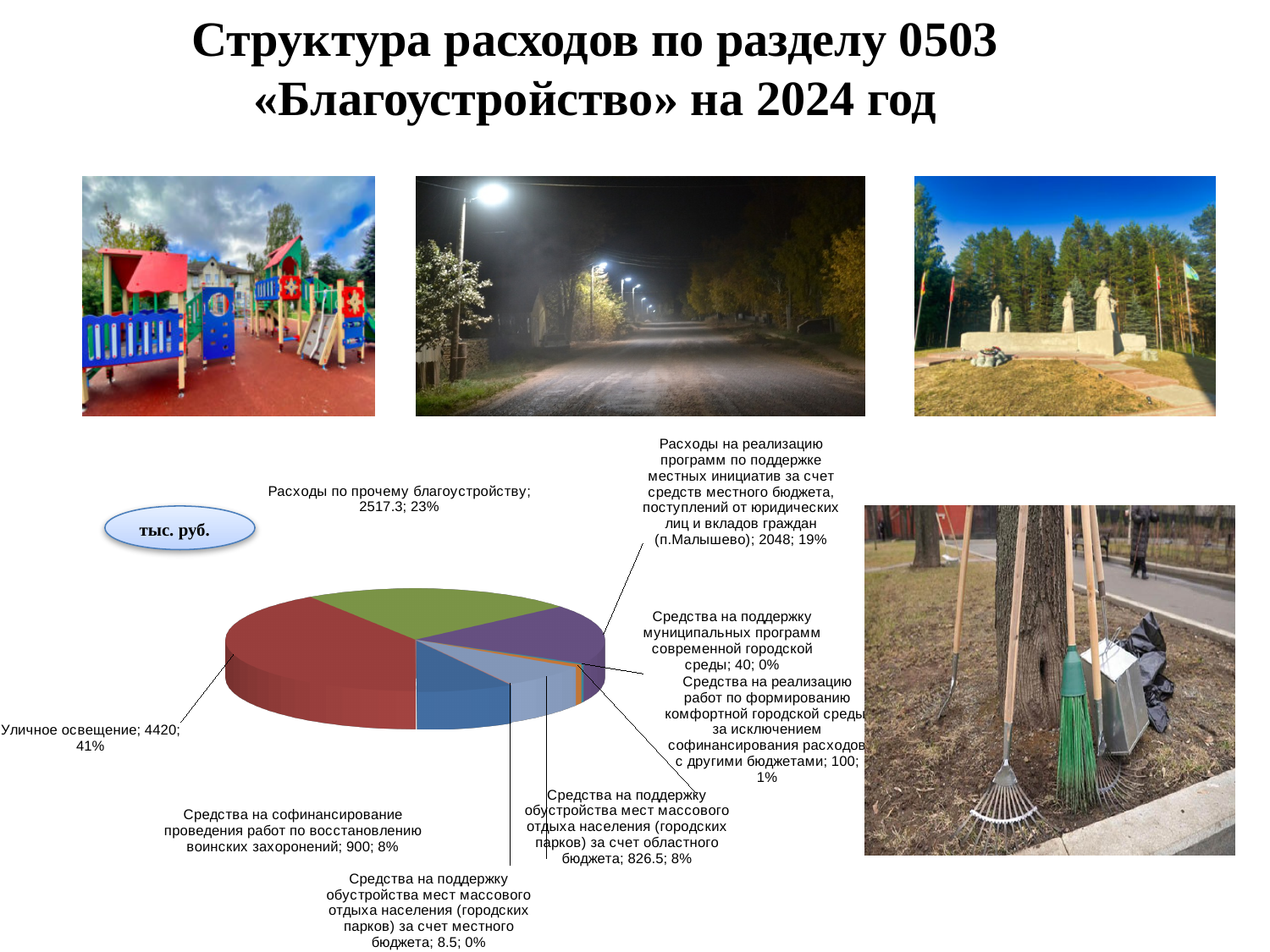
How many slices does the pie chart have? 8 What is the value for «Средства на реализацию работ по формированию комфортной городской среды за исключением софинансирования расходов с другими бюджетами»? 100 What is the difference between the values for «Уличное освещение» and «Расходы по прочему благоустройству»? 1902.7 Which is larger: the value for «Средства на поддержку обустройства мест массового отдыха населения (городских парков) за счет областного бюджета» or for «Средства на софинансирование проведения работ по восстановлению воинских захоронений»? Средства на софинансирование проведения работ по восстановлению воинских захоронений What is the value for «Уличное освещение» in the pie chart? 4420 What is the value for «Средства на софинансирование проведения работ по восстановлению воинских захоронений»? 900 Which category has the smallest value in the pie chart? Средства на поддержку обустройства мест массового отдыха населения (городских парков) за счет местного бюджета Which category has the largest slice in the pie chart? Уличное освещение What share of the pie does «Расходы по прочему благоустройству» represent? 23% What share of the pie does the slice for «п.Малышево» local initiatives programme (Расходы на реализацию программ по поддержке местных инициатив) represent? 19% In what units are the values in the pie chart given, according to the callout on the slide? тыс. руб. What type of chart is shown on the slide? pie chart